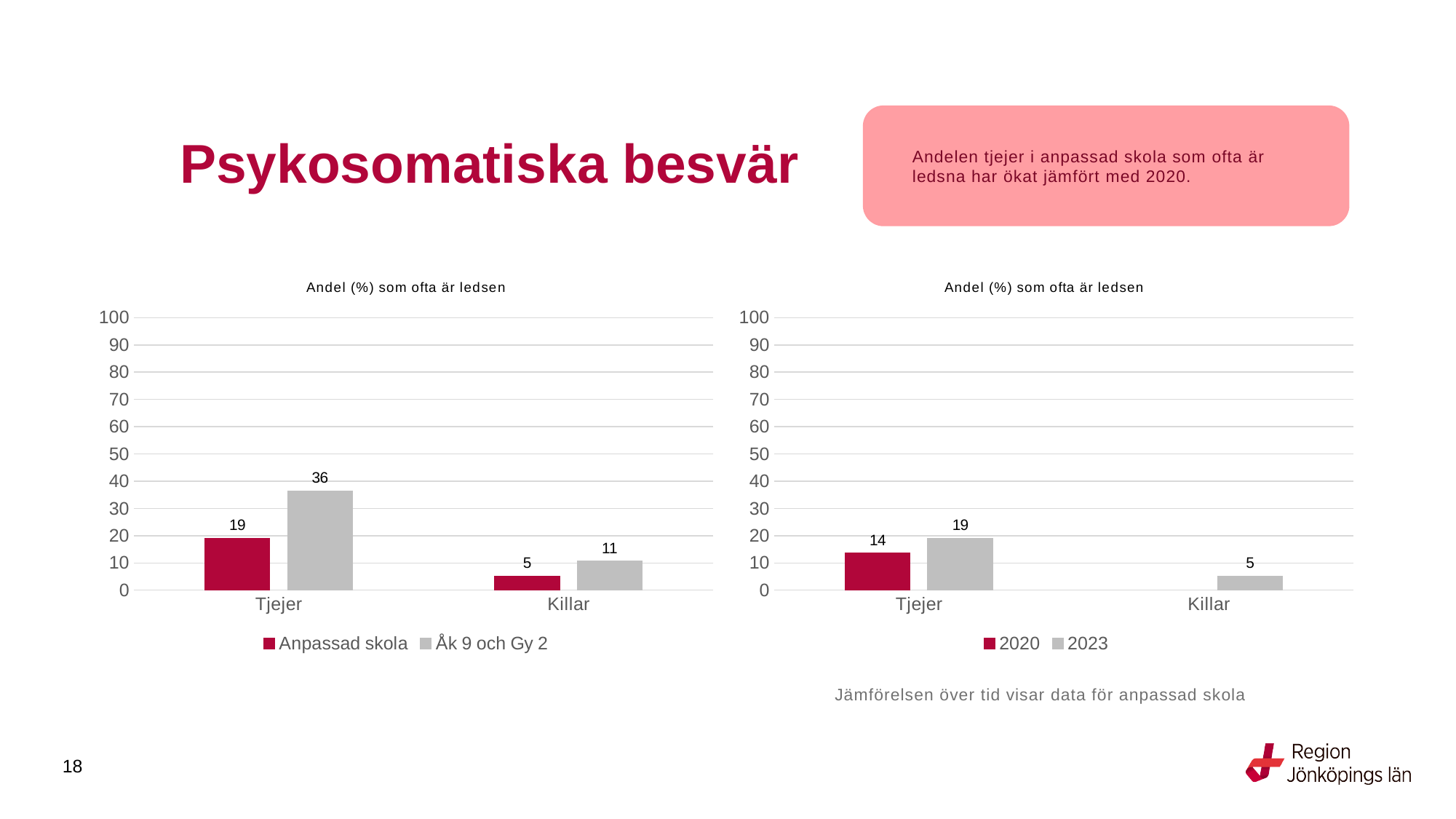
In the left chart, how many series does the legend list? 2 In the right chart, what is the value for Tjejer in 2020? 14 In the left chart, which is larger for Killar: Anpassad skola or Åk 9 och Gy 2? Åk 9 och Gy 2 In the left chart, what is the difference between the Åk 9 och Gy 2 and Anpassad skola values for Tjejer? 17 What is the title of the left chart? Andel (%) som ofta är ledsen In the right chart, what is the difference between the 2023 and 2020 values for Tjejer? 5 What kind of chart is the right chart? Bar chart In the left chart, what is the value for Tjejer in the Anpassad skola series? 19 In the right chart, what is the value for Killar in 2023? 5 In the right chart, is the 2023 value for Tjejer greater or less than 10? greater In the left chart, which category has the highest value in the Åk 9 och Gy 2 series? Tjejer In the left chart, what is the value for Killar in the Åk 9 och Gy 2 series? 11